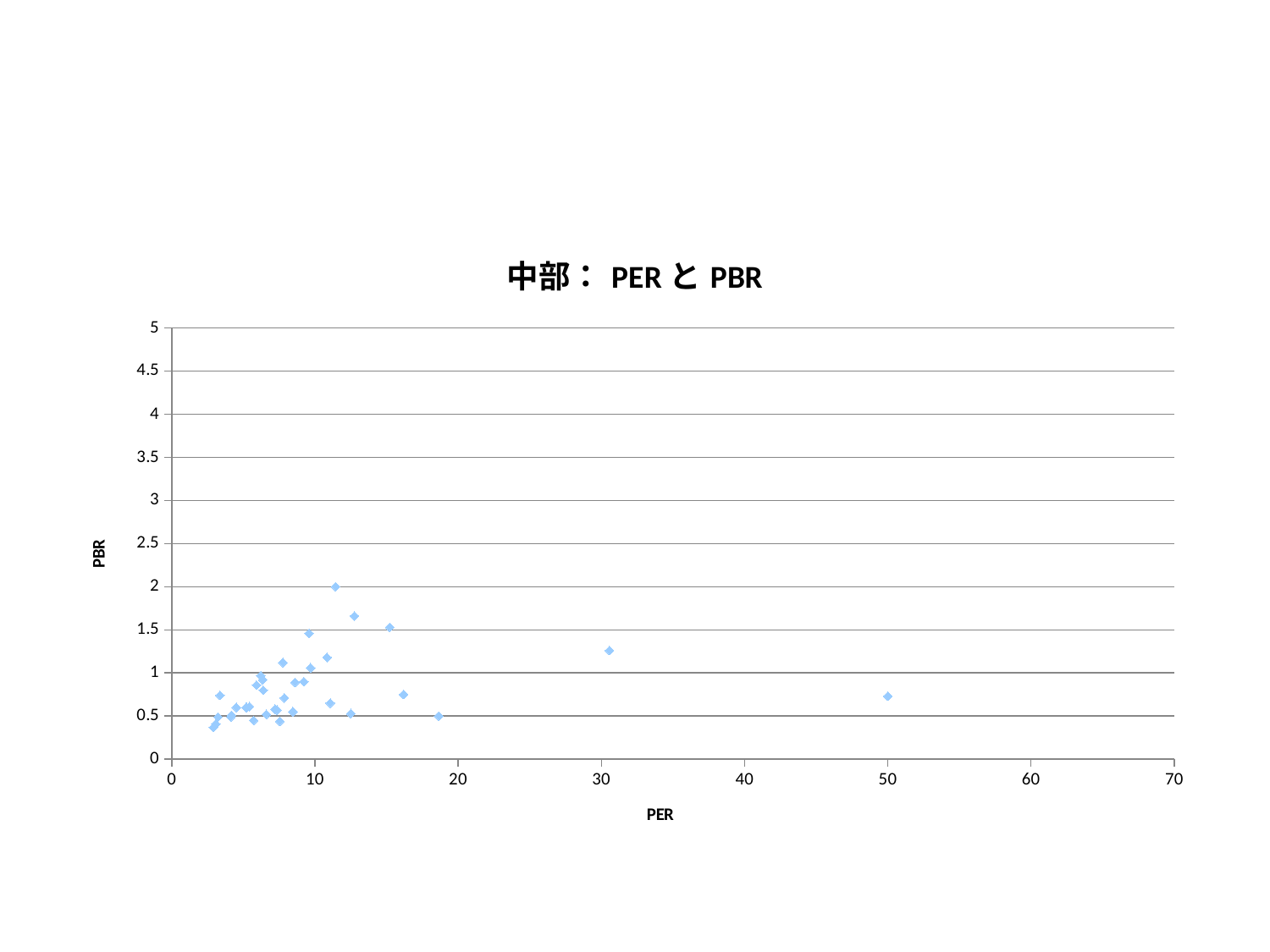
What is the highest value shown on the x axis (PER)? 70 What is the title of the chart? 中部： PER と PBR Is the PBR of the point with the highest PBR value greater or less than 2.5? less Is the PBR of the point with the highest PBR value greater or less than 1.5? greater How many points have a PER greater than 20? 2 Is the PER of the point with the largest PER value greater or less than 40? greater What kind of chart is shown on the slide? scatter chart How many points have a PER greater than 40? 1 Are most of the points located at a PER below 20 or above 20? below 20 What are the labels of the x axis and the y axis of the chart? PER (x axis) and PBR (y axis)